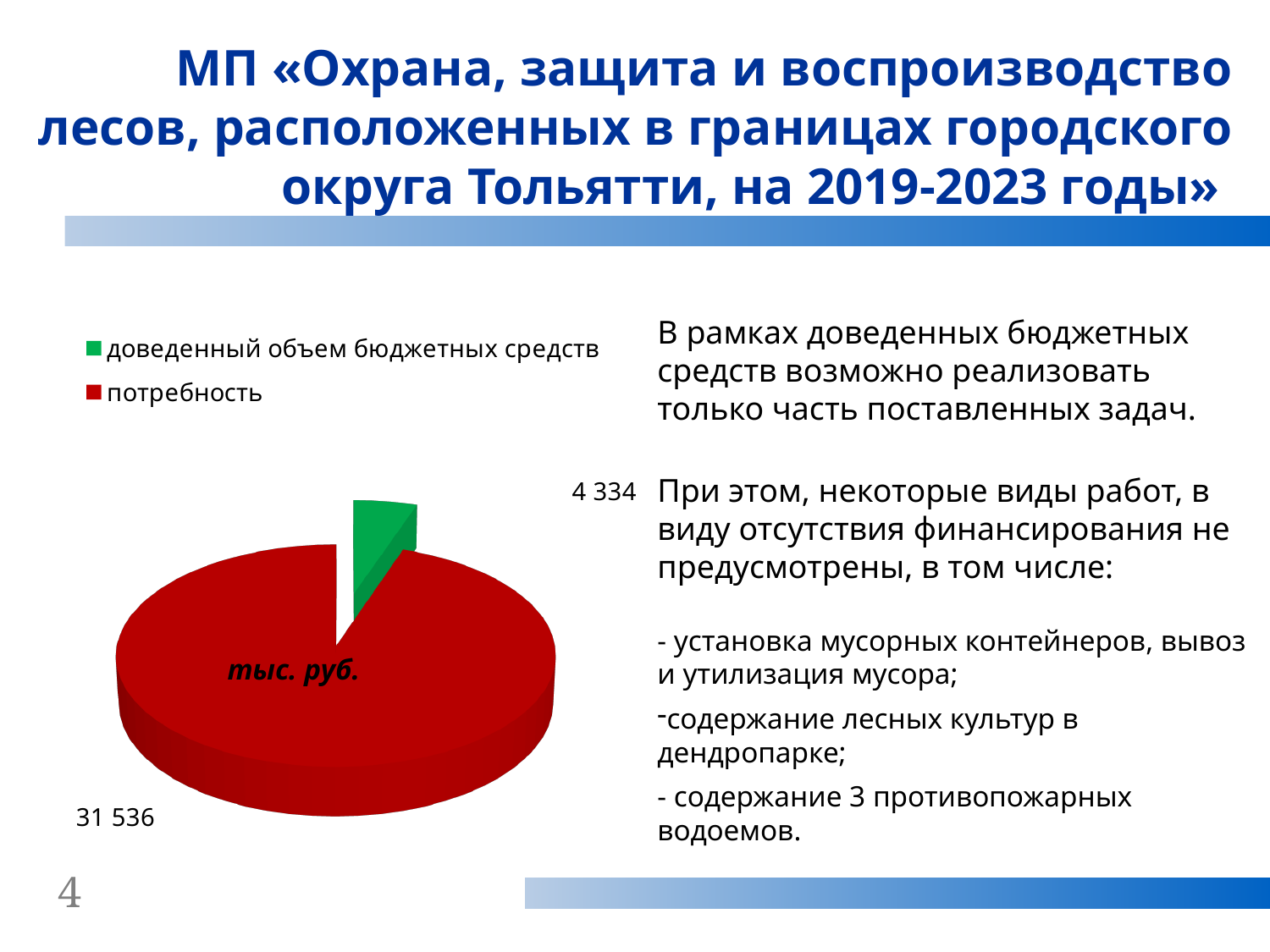
What unit is written in the centre of the pie chart? тыс. руб. What is the value for «потребность» in the pie chart? 31 536 What type of chart is shown on the slide? pie chart How many entries does the legend of the pie chart list? 2 What is the total of the two values shown in the pie chart? 35 870 What is the value for «доведенный объем бюджетных средств» in the pie chart? 4 334 Which slice of the pie chart is the largest? потребность Which is larger in the pie chart: «потребность» or «доведенный объем бюджетных средств»? потребность Which slice of the pie chart is the smallest? доведенный объем бюджетных средств How many slices does the pie chart have? 2 What colour is the «потребность» slice in the pie chart? red What is the difference between «потребность» and «доведенный объем бюджетных средств» in the pie chart? 27 202